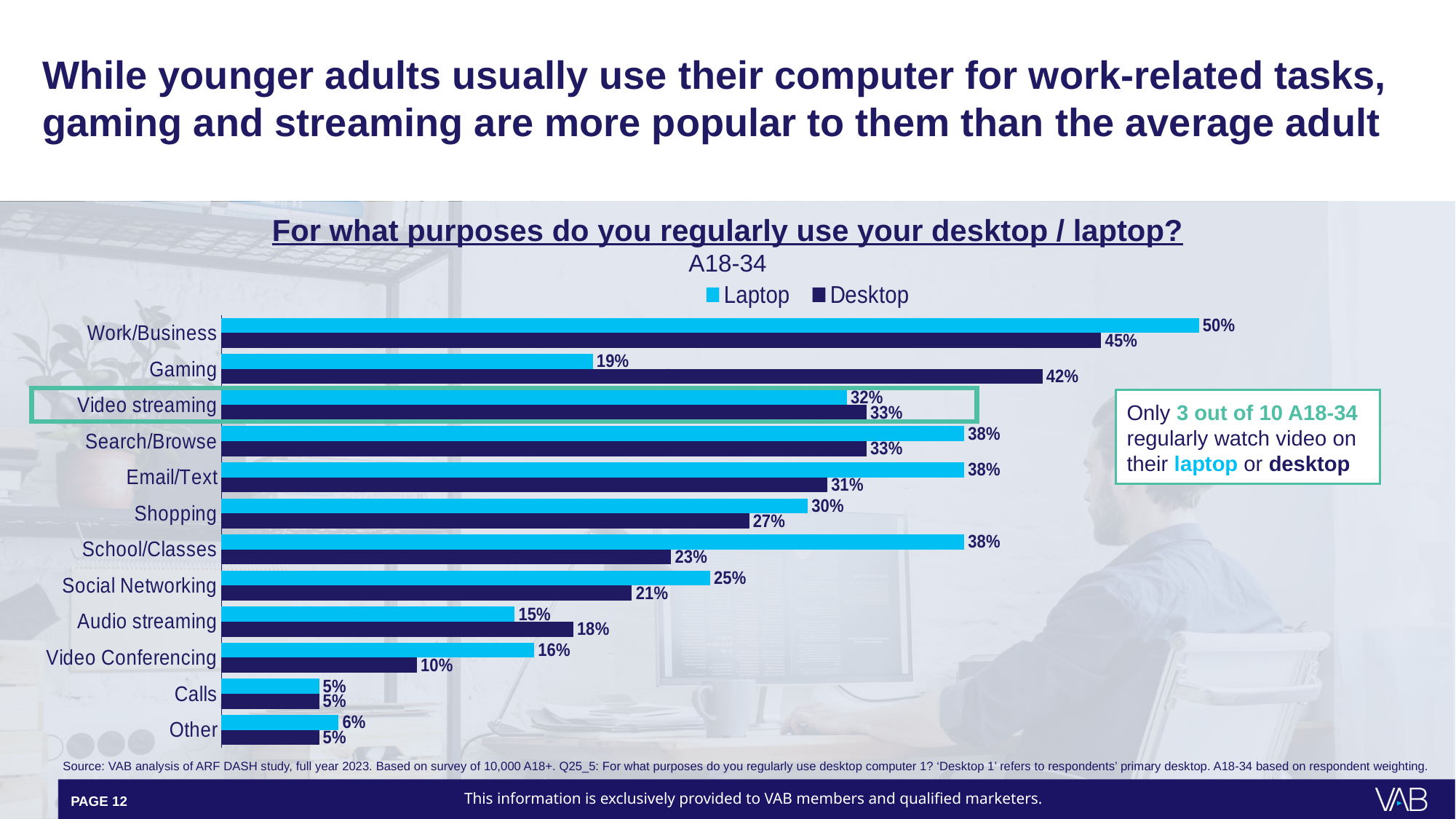
What is the Desktop value for Video Conferencing? 10% How many series does the legend list? 2 Which category has the highest Laptop value? Work/Business Which age group does the chart cover, according to its subtitle? A18-34 What kind of chart is shown on the slide? Bar chart What percentage of A18-34 regularly use their laptop for Work/Business? 50% How many purpose categories are shown in the chart? 12 What is the difference between the Laptop values for Work/Business and Calls? 45% What percentage of A18-34 regularly use their desktop for Gaming? 42% For Audio streaming, which is larger: the Laptop value or the Desktop value? Desktop What is the difference between the Laptop and Desktop values for Gaming? 23% Which category has the lowest Desktop value? Calls and Other (both 5%)